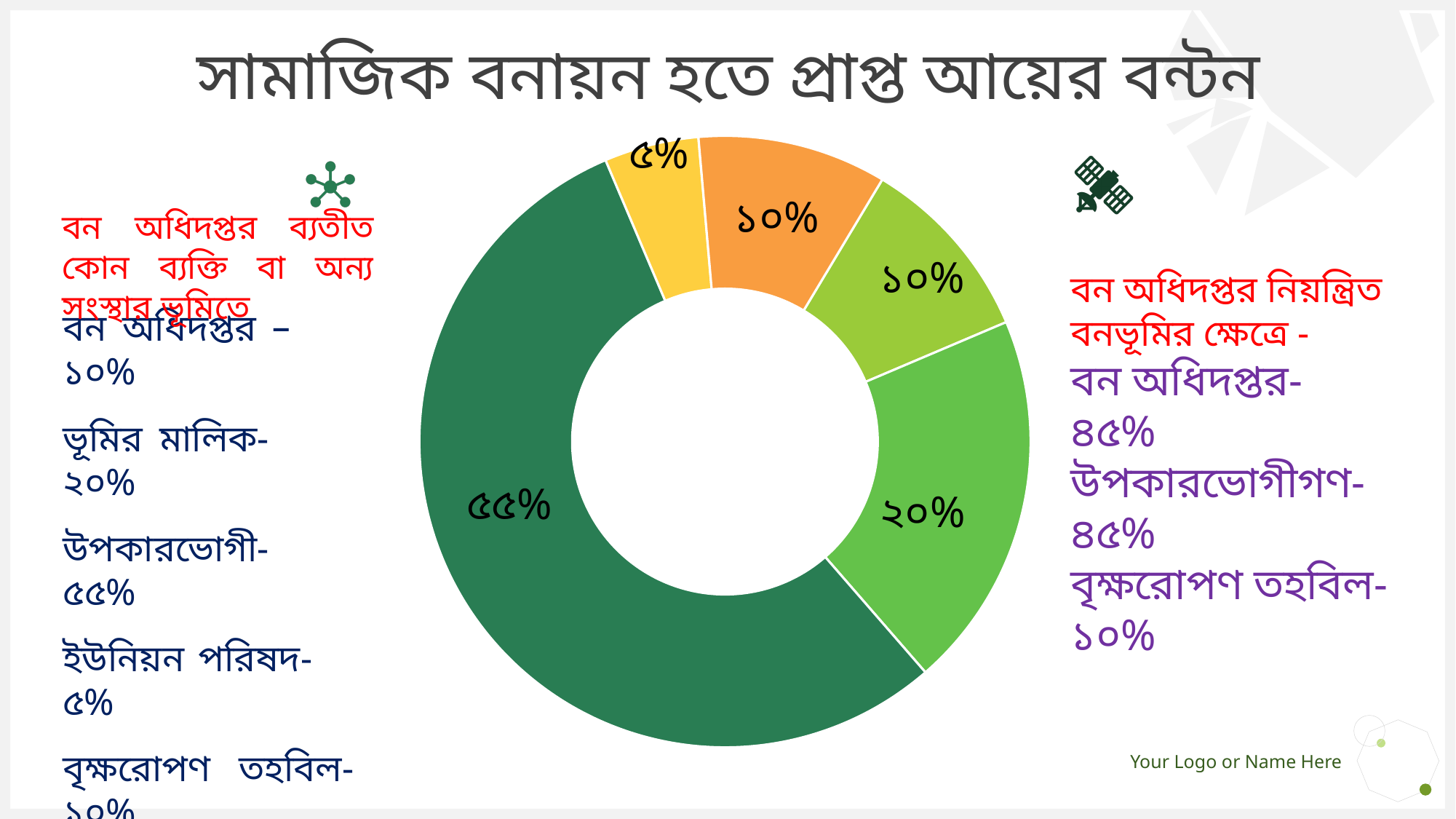
What is the value of the smallest slice in the chart? ৫% What value is printed on the medium green slice on the right side of the chart? ২০% What value is printed on the yellow slice? ৫% What is the title of the slide containing the chart? সামাজিক বনায়ন হতে প্রাপ্ত আয়ের বন্টন According to the text on the left of the slide, which category corresponds to the ৫৫% slice? উপকারভোগী Which slice is larger, the orange slice or the yellow slice? the orange slice How many slices does the chart have? 5 What value is printed on the orange slice? ১০% What is the difference between the largest slice (৫৫%) and the ২০% slice? ৩৫% What kind of chart is shown on the slide? pie chart (donut) What value is printed on the dark green slice? ৫৫% What is the value of the largest slice in the chart? ৫৫%